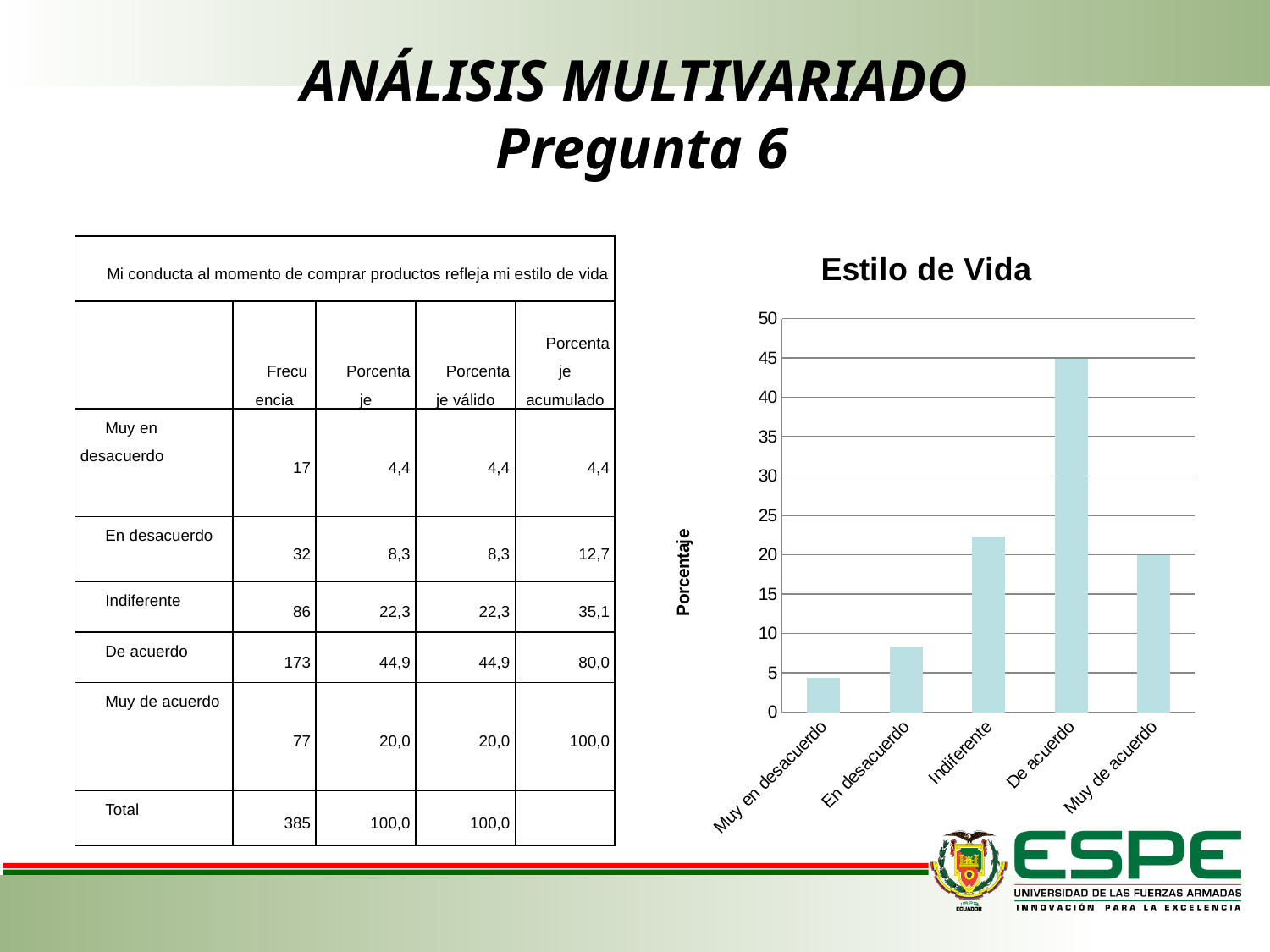
Do the values rise or fall from Muy en desacuerdo to De acuerdo along the x axis? rise Which is larger, the value for Indiferente or the value for Muy de acuerdo? Indiferente How many categories are shown on the x axis of the chart? 5 What kind of chart is shown on the slide? bar chart What is the title of the chart? Estilo de Vida What is the value for Muy de acuerdo in the chart? 20 Is the value for Indiferente greater or less than 25? less Is the value for De acuerdo greater or less than 40? greater Is the value for En desacuerdo greater or less than 10? less Which category has the lowest bar in the chart? Muy en desacuerdo What is the label of the y axis of the chart? Porcentaje Which category has the highest bar in the chart? De acuerdo